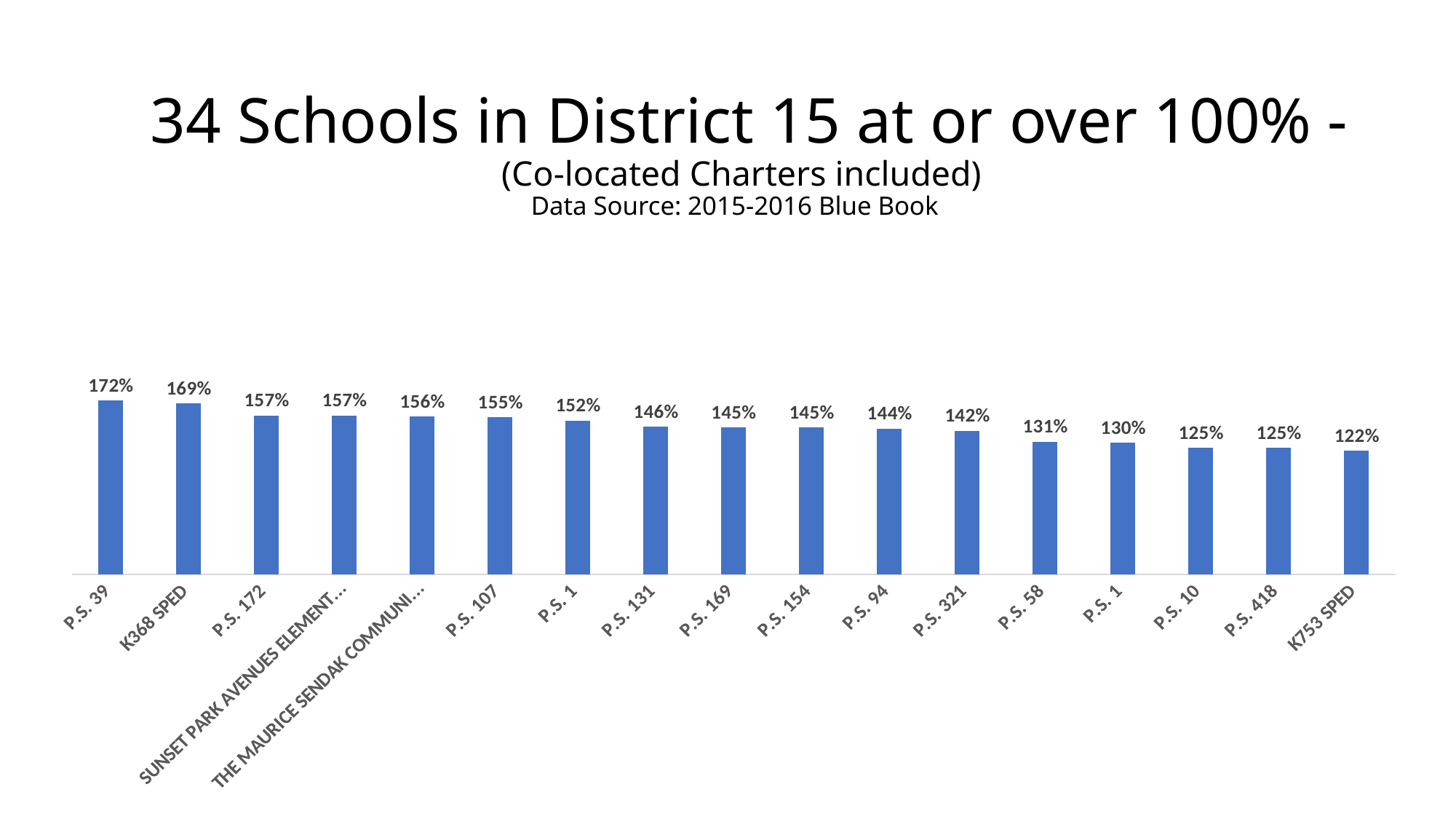
What is the difference between the values for P.S. 39 and K753 SPED? 50% Which is larger, the value for P.S. 131 or the value for P.S. 10? P.S. 131 What data source is cited under the chart title? 2015-2016 Blue Book What is the value for K753 SPED? 122% Which school has the highest value on the chart? P.S. 39 What is the value for P.S. 39? 172% Which school has the lowest value on the chart? K753 SPED What is the difference between the values for P.S. 107 and P.S. 58? 24% What kind of chart is shown on the slide? Bar chart What is the value for K368 SPED? 169% How many bars are plotted on the chart? 17 What is the value for P.S. 321? 142%